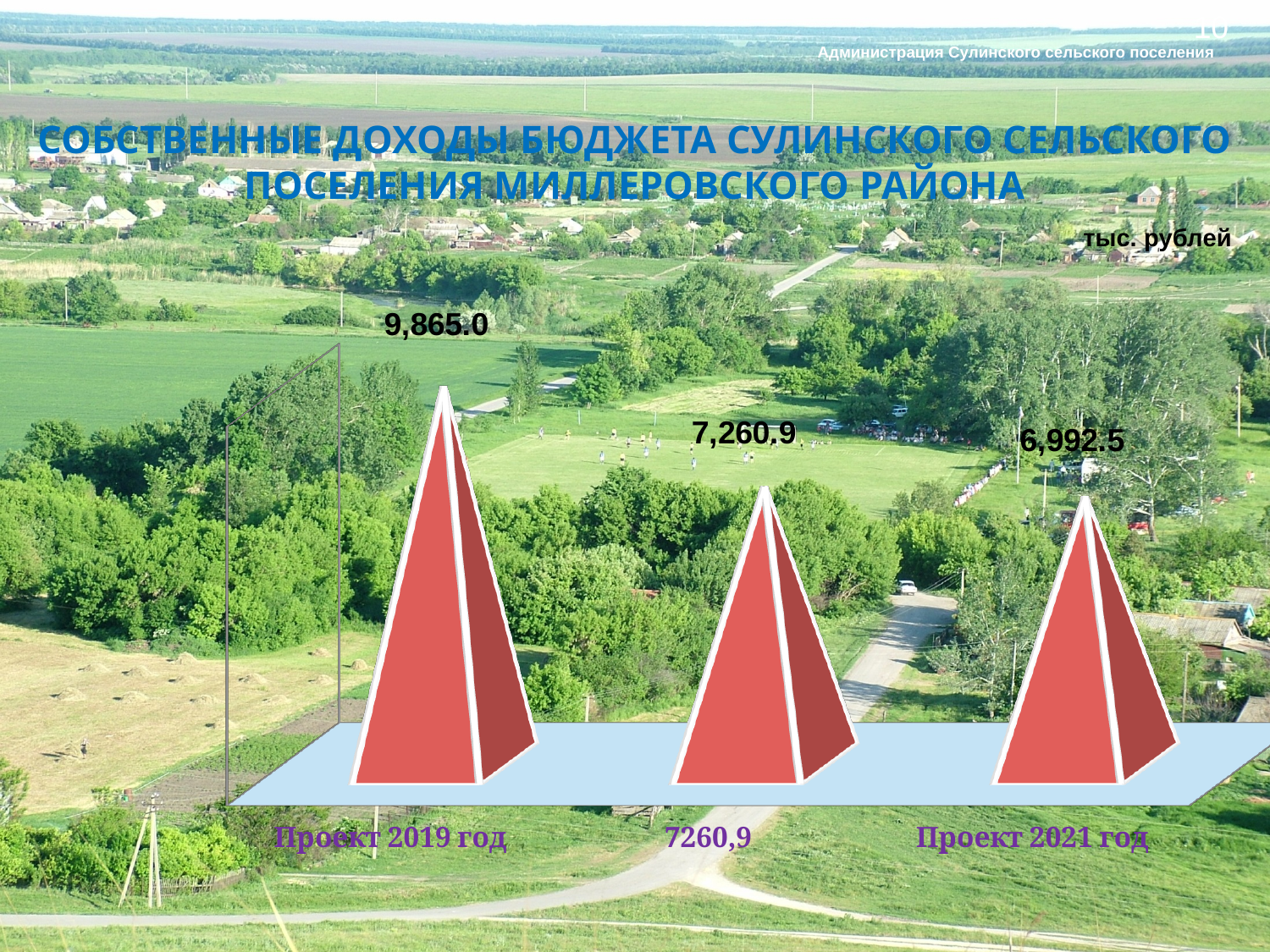
What is the value for Проект 2019 год? 9,865.0 What kind of chart is shown on the slide? Bar chart Which category has the highest value? Проект 2019 год What unit of measurement is stated for the chart values? тыс. рублей Which category has the lowest value? Проект 2021 год What is the difference between the values for Проект 2019 год and Проект 2021 год? 2,872.5 Which is larger, the value for Проект 2019 год or the value for Проект 2021 год? Проект 2019 год Do the values rise or fall from left to right across the chart? Fall What is the value shown above the middle pyramid? 7,260.9 What is the value for Проект 2021 год? 6,992.5 What is the difference between the value for Проект 2019 год and the middle pyramid's value of 7,260.9? 2,604.1 How many categories are plotted in the chart? 3